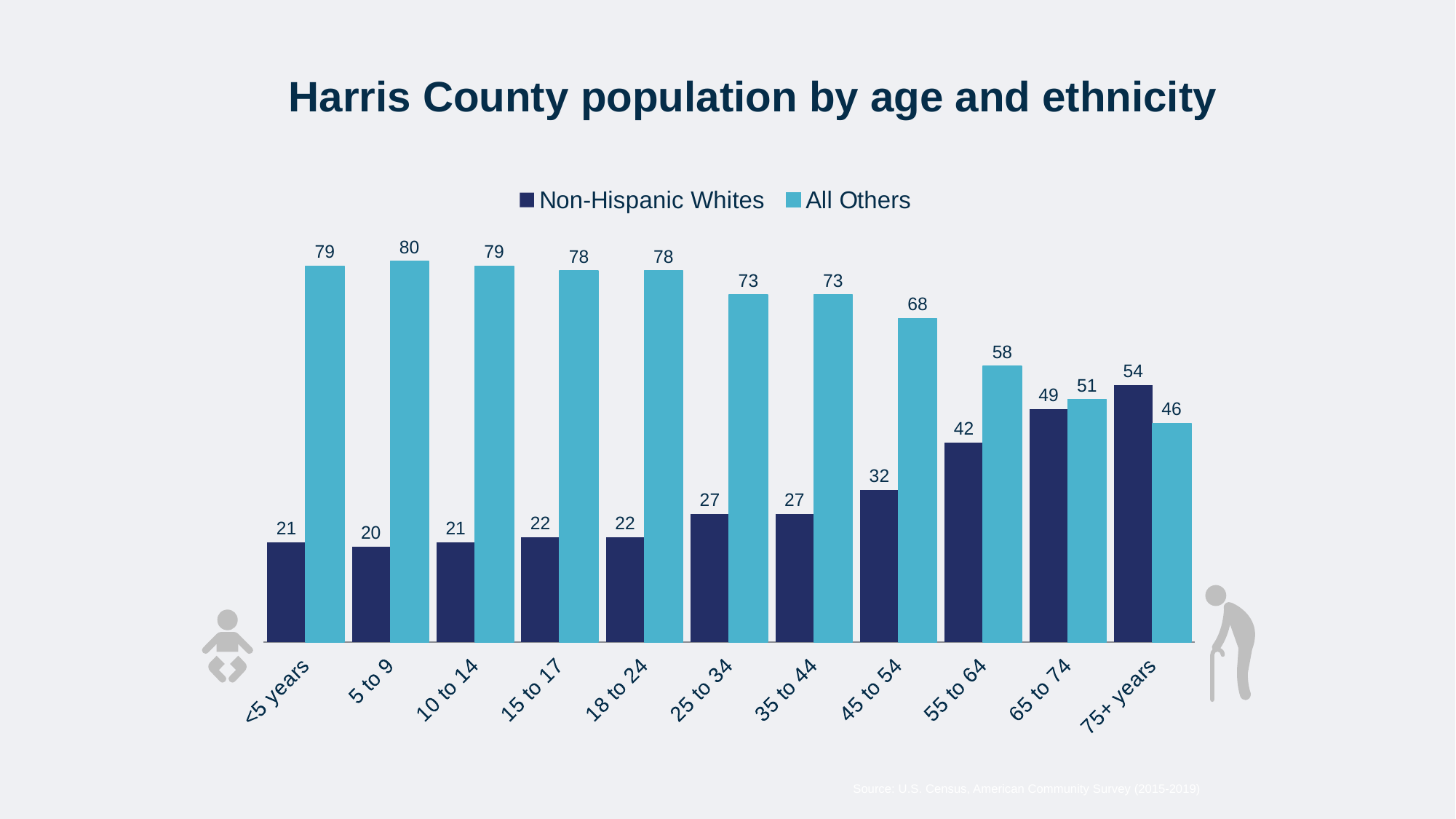
How many age groups are shown on the x axis? 11 What is the difference between All Others and Non-Hispanic Whites in the 25 to 34 age group? 46 What is the value for All Others in the 5 to 9 age group? 80 Do the values for Non-Hispanic Whites rise or fall as age increases along the x axis? Rise What is the title of the chart? Harris County population by age and ethnicity Which age group has the highest value for All Others? 5 to 9 In the 75+ years age group, which series has the larger value, Non-Hispanic Whites or All Others? Non-Hispanic Whites How many series does the legend list? 2 What is the value for Non-Hispanic Whites in the 45 to 54 age group? 32 Which age group has the lowest value for Non-Hispanic Whites? 5 to 9 What is the value for Non-Hispanic Whites in the 75+ years age group? 54 What kind of chart is shown on the slide? Bar chart